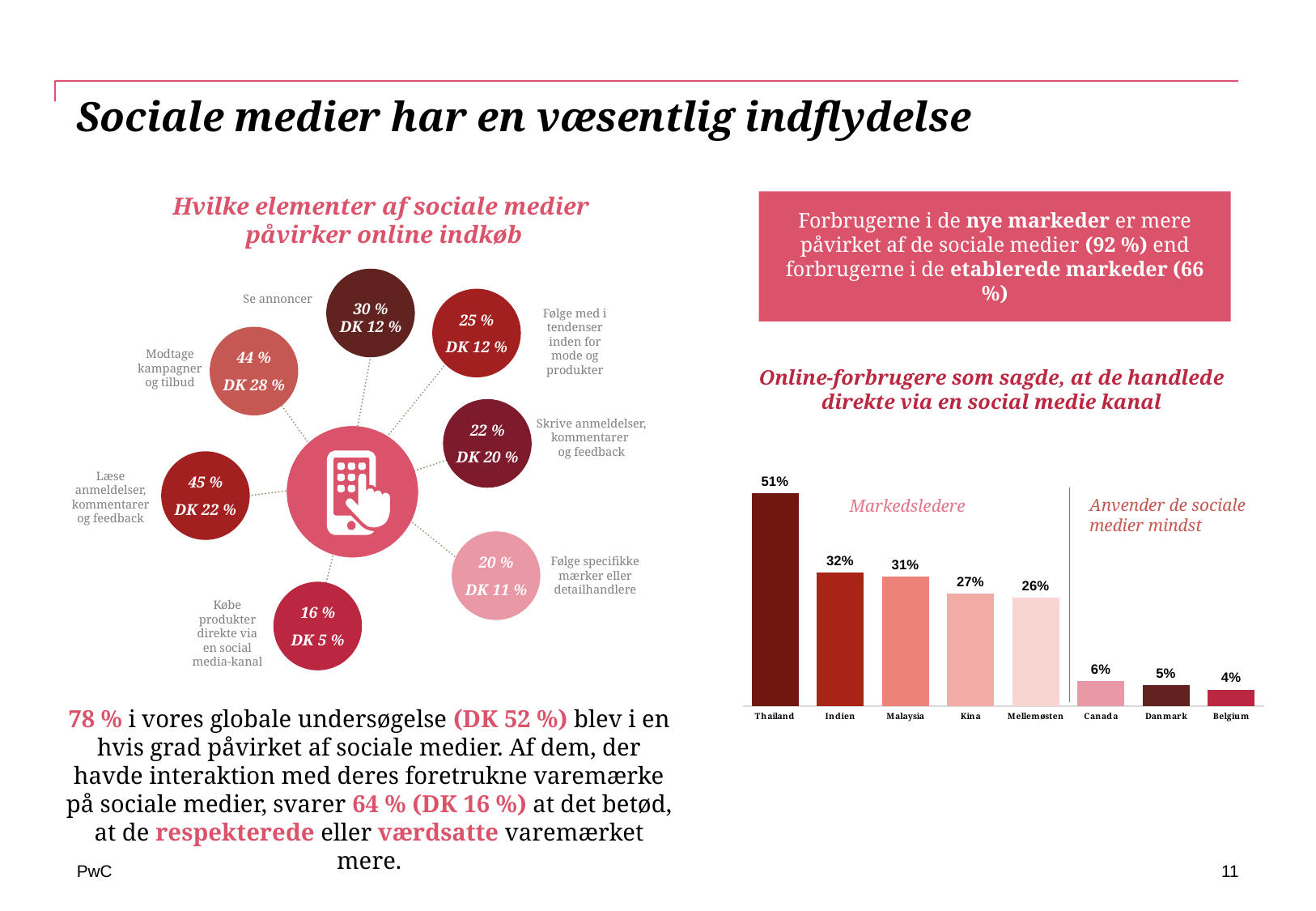
In the chart 'Online-forbrugere som sagde, at de handlede direkte via en social medie kanal', what is the value for Thailand? 51% In the chart 'Online-forbrugere som sagde, at de handlede direkte via en social medie kanal', what is the value for Mellemøsten? 26% In the chart 'Online-forbrugere som sagde, at de handlede direkte via en social medie kanal', how many countries or regions are shown? 8 In the chart 'Online-forbrugere som sagde, at de handlede direkte via en social medie kanal', what is the difference between Canada and Belgium? 2% In the chart 'Online-forbrugere som sagde, at de handlede direkte via en social medie kanal', what is the difference between Thailand and Indien? 19% In the chart 'Online-forbrugere som sagde, at de handlede direkte via en social medie kanal', what are the two group labels shown above the bars? Markedsledere; Anvender de sociale medier mindst In the chart 'Online-forbrugere som sagde, at de handlede direkte via en social medie kanal', which country has the highest value? Thailand What kind of chart is 'Online-forbrugere som sagde, at de handlede direkte via en social medie kanal'? Bar chart In the chart 'Online-forbrugere som sagde, at de handlede direkte via en social medie kanal', which is larger, Kina or Canada? Kina In the chart 'Online-forbrugere som sagde, at de handlede direkte via en social medie kanal', do the values rise or fall from Thailand to Belgium? Fall In the chart 'Online-forbrugere som sagde, at de handlede direkte via en social medie kanal', which category has the lowest value? Belgium In the chart 'Online-forbrugere som sagde, at de handlede direkte via en social medie kanal', what is the value for Danmark? 5%